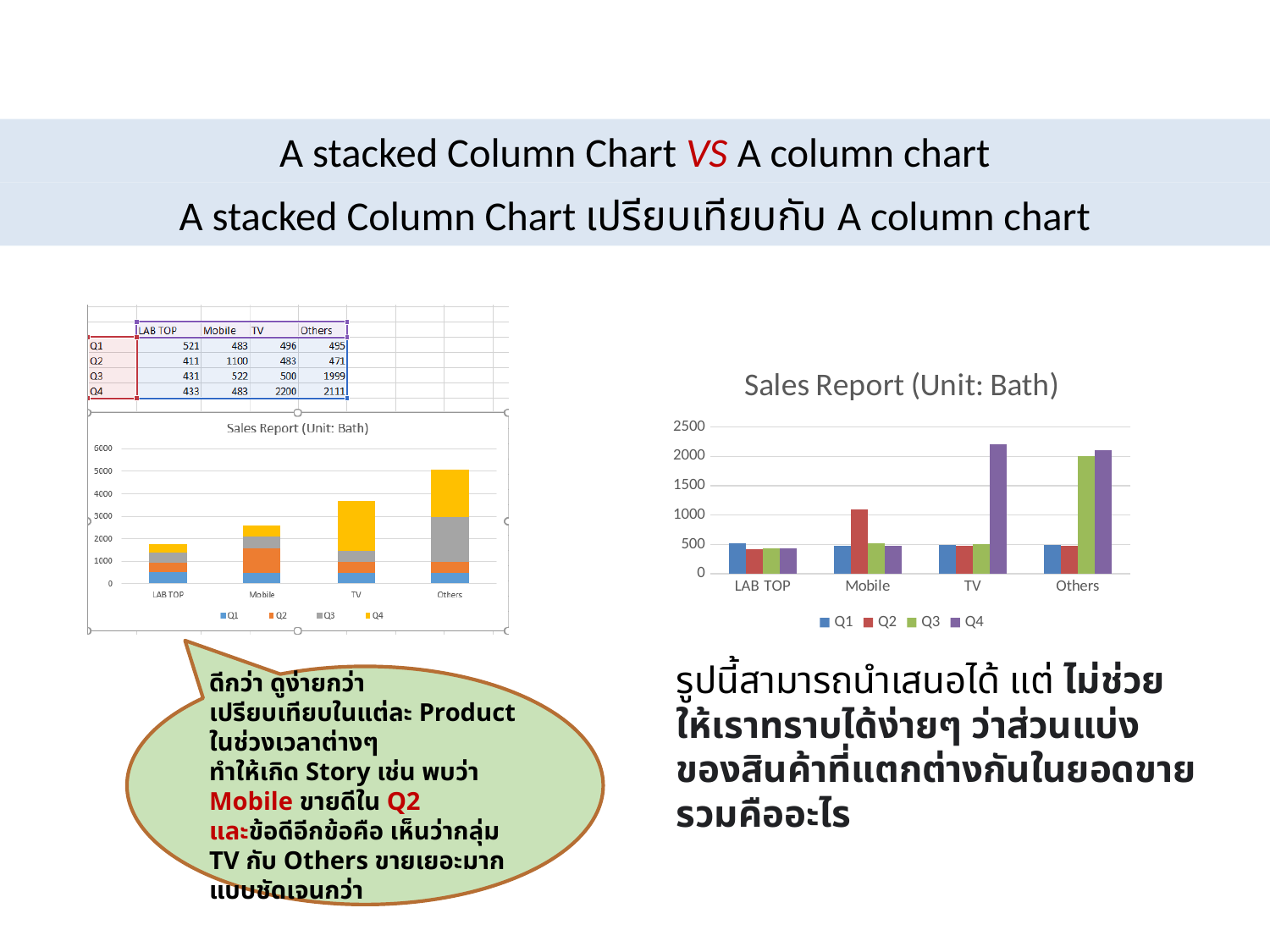
How many series does the legend of the right-hand chart list? 4 In the left-hand stacked chart, which category has the shortest stacked bar? LAB TOP In the right-hand chart, is the Q4 value for TV greater or less than 2000? greater What kind of chart is the chart on the left side of the slide? Stacked bar chart In the left-hand stacked chart, which category has the tallest stacked bar? Others What is the title of the right-hand chart? Sales Report (Unit: Bath) In the right-hand chart, is the Q2 value for Mobile greater or less than 1000? greater In the left-hand stacked chart, is the total stacked bar for TV greater or less than 3000? greater In the right-hand chart, which category has the highest Q2 value? Mobile In the right-hand chart, which category has the highest Q3 value? Others How many product categories are shown on the x axis of the right-hand chart? 4 What kind of chart is the chart on the right side of the slide? Bar chart